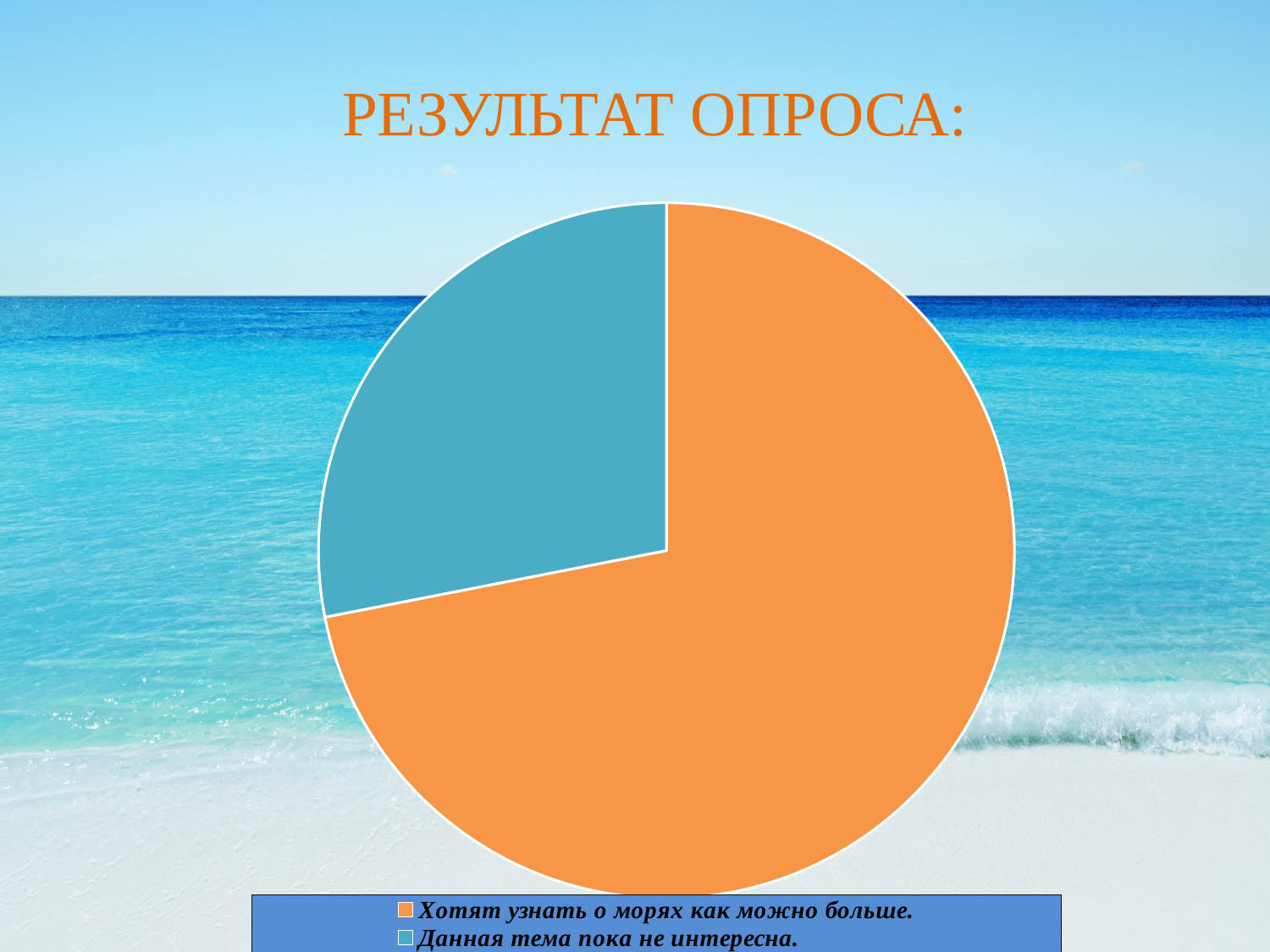
How many slices does the pie chart have? 2 How many entries does the legend of the pie chart list? 2 Which is larger in the pie chart: the slice for "Хотят узнать о морях как можно больше." or the slice for "Данная тема пока не интересна."? Хотят узнать о морях как можно больше. What kind of chart is shown on the slide? pie chart What colour is the slice for "Данная тема пока не интересна." in the pie chart? teal (blue) What is the title of the slide containing the pie chart? РЕЗУЛЬТАТ ОПРОСА: Which slice of the pie chart is the smallest? Данная тема пока не интересна. Which slice of the pie chart is the largest? Хотят узнать о морях как можно больше. Does the slice "Хотят узнать о морях как можно больше." take up more or less than half of the pie chart? more